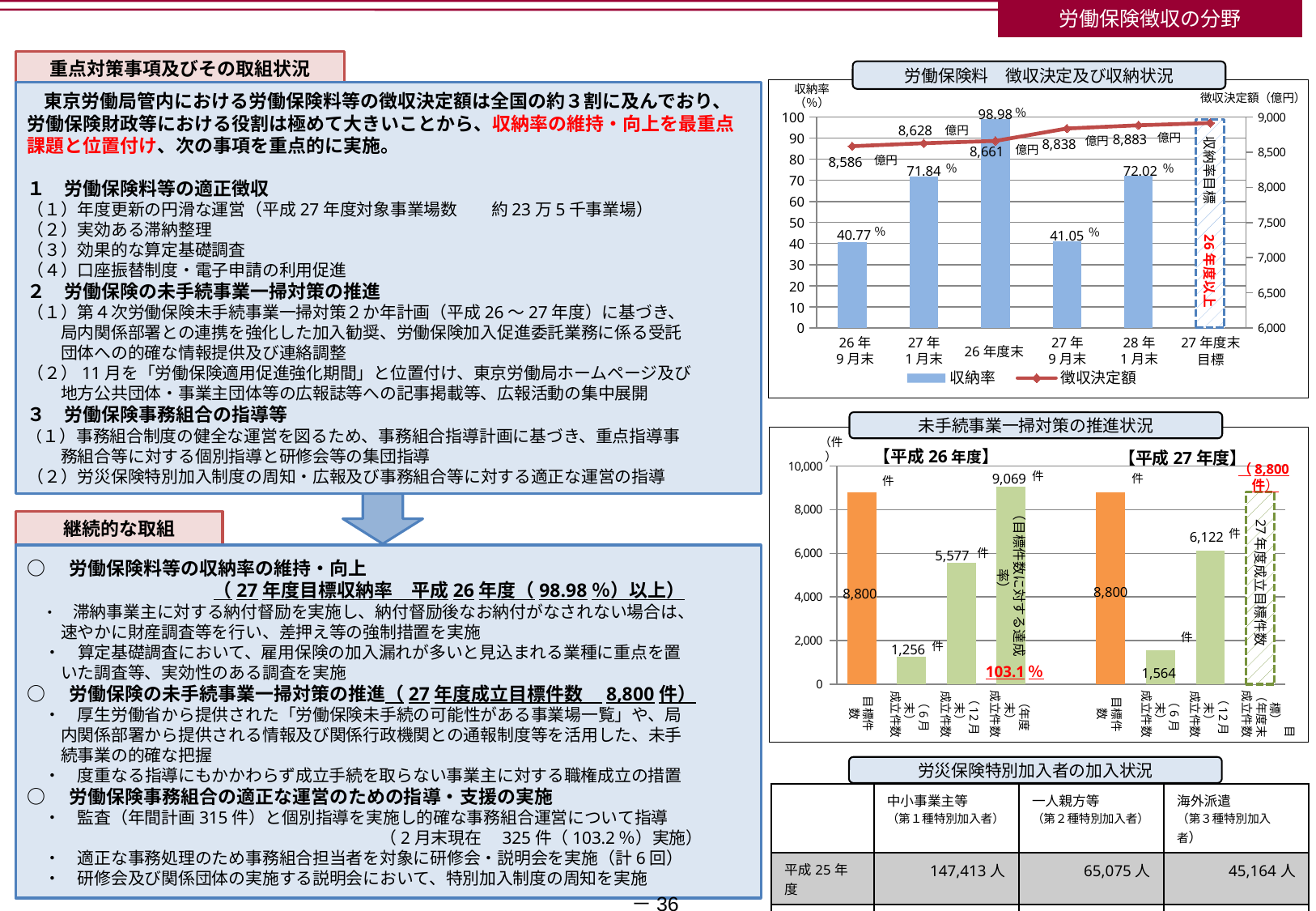
In the chart titled 未手続事業一掃対策の推進状況, what is the 目標件数 for 平成27年度? 8,800 In the chart titled 労働保険料 徴収決定及び収納状況, what is the 収納率 at 26年度末? 98.98% In the chart titled 未手続事業一掃対策の推進状況, what is the 成立件数 at 年度末 for 平成26年度? 9,069件 In the chart titled 労働保険料 徴収決定及び収納状況, what is the difference in 徴収決定額 between 27年9月末 and 26年9月末? 252億円 In the chart titled 労働保険料 徴収決定及び収納状況, what is the 徴収決定額 at 28年1月末? 8,883億円 In the chart titled 未手続事業一掃対策の推進状況, what is the 成立件数 at 12月末 for 平成27年度? 6,122件 In the chart titled 未手続事業一掃対策の推進状況, what is the difference between the 成立件数 at 12月末 for 平成27年度 and for 平成26年度? 545件 In the chart titled 未手続事業一掃対策の推進状況, which is larger: the 成立件数 at 6月末 for 平成26年度 or for 平成27年度? 平成27年度 In the chart titled 労働保険料 徴収決定及び収納状況, does the 徴収決定額 line rise or fall from 26年9月末 to 28年1月末? rise In the chart titled 労働保険料 徴収決定及び収納状況, what is the 収納率 at 27年9月末? 41.05% In the chart titled 労働保険料 徴収決定及び収納状況, which of the labelled periods has the lowest 収納率? 26年9月末 In the chart titled 労働保険料 徴収決定及び収納状況, how many series does the legend list? 2